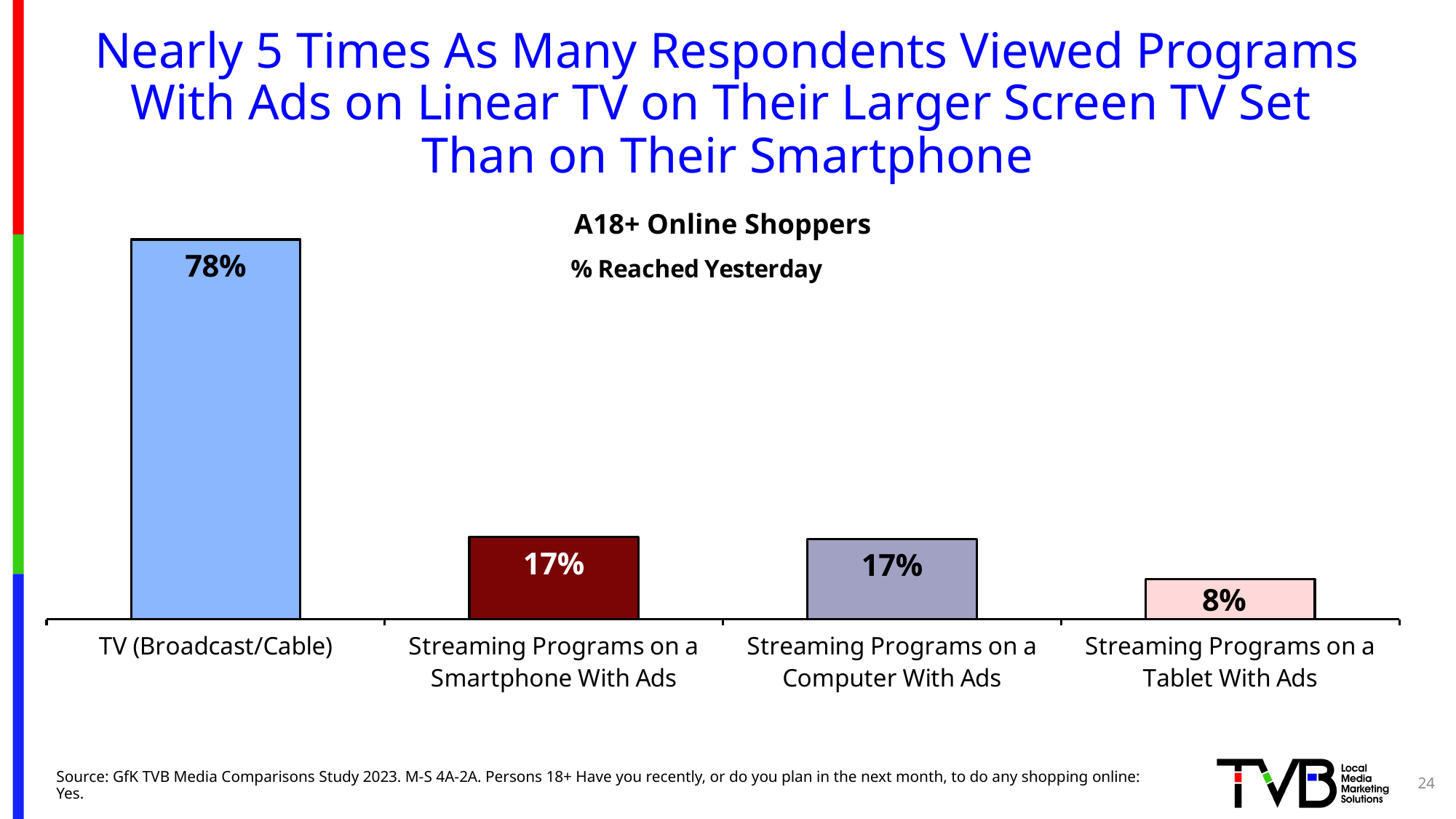
What is the difference between the value for TV (Broadcast/Cable) and the value for Streaming Programs on a Smartphone With Ads? 61% What is the value for TV (Broadcast/Cable)? 78% Which is larger: the value for TV (Broadcast/Cable) or the value for Streaming Programs on a Tablet With Ads? TV (Broadcast/Cable) What colour is the bar for Streaming Programs on a Smartphone With Ads? Dark red What is the difference between the value for Streaming Programs on a Computer With Ads and the value for Streaming Programs on a Tablet With Ads? 9% Which category has the lowest value? Streaming Programs on a Tablet With Ads How many categories are shown in the chart? 4 What kind of chart is shown on the slide? Bar chart What is the value for Streaming Programs on a Smartphone With Ads? 17% Which category has the highest value? TV (Broadcast/Cable) What is the title of the chart? A18+ Online Shoppers % Reached Yesterday What is the value for Streaming Programs on a Tablet With Ads? 8%